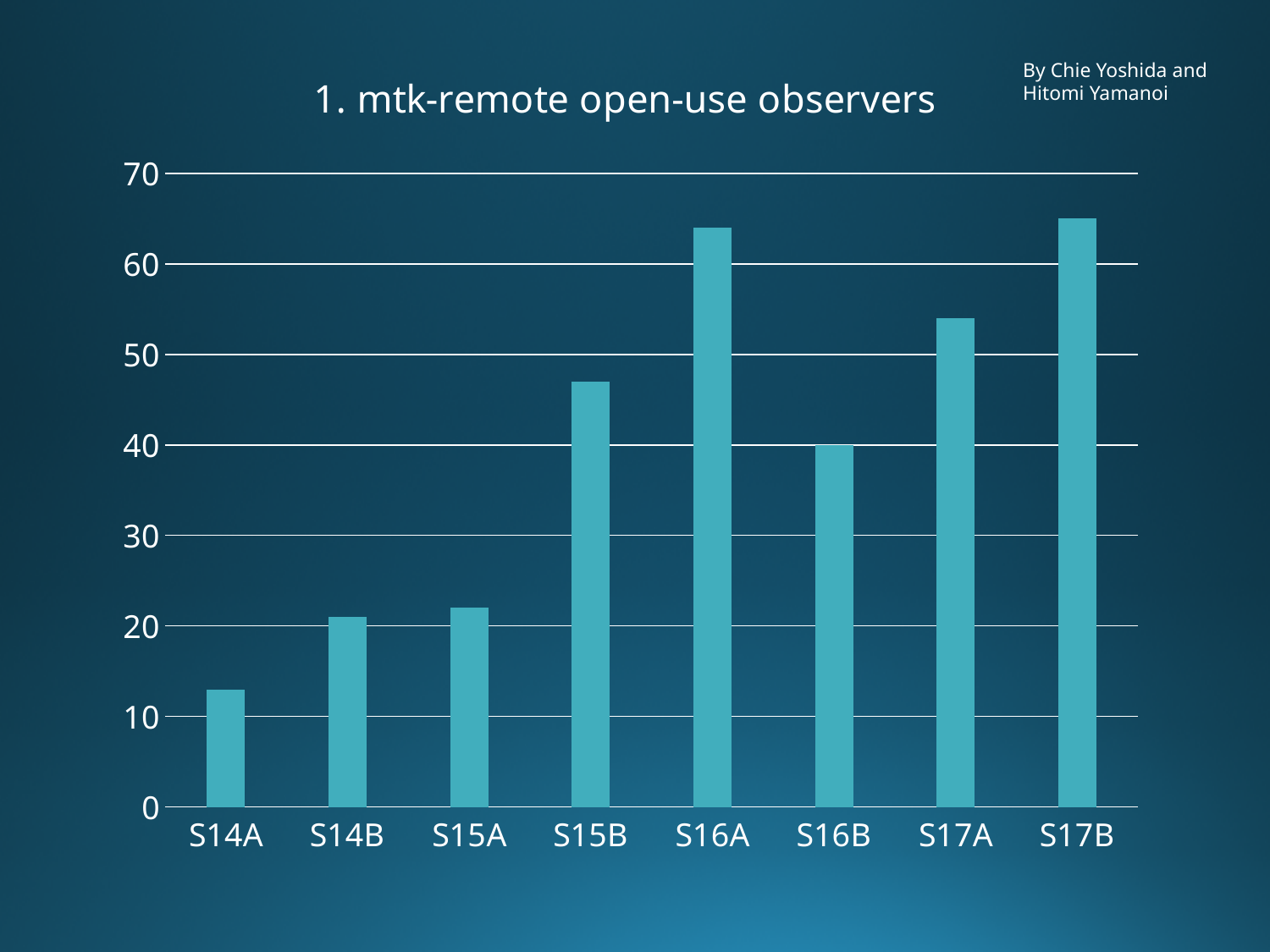
How many categories are shown on the x axis? 8 Is the value for S17A greater or less than 60? less Is the value for S15B greater or less than 40? greater Which is larger, the value for S16A or the value for S16B? S16A Is the value for S14A greater or less than 20? less What is the title of the chart? 1. mtk-remote open-use observers What kind of chart is shown on the slide? bar chart What is the value for S16B? 40 Which is larger, the value for S15B or the value for S17A? S17A Which category has the lowest value? S14A